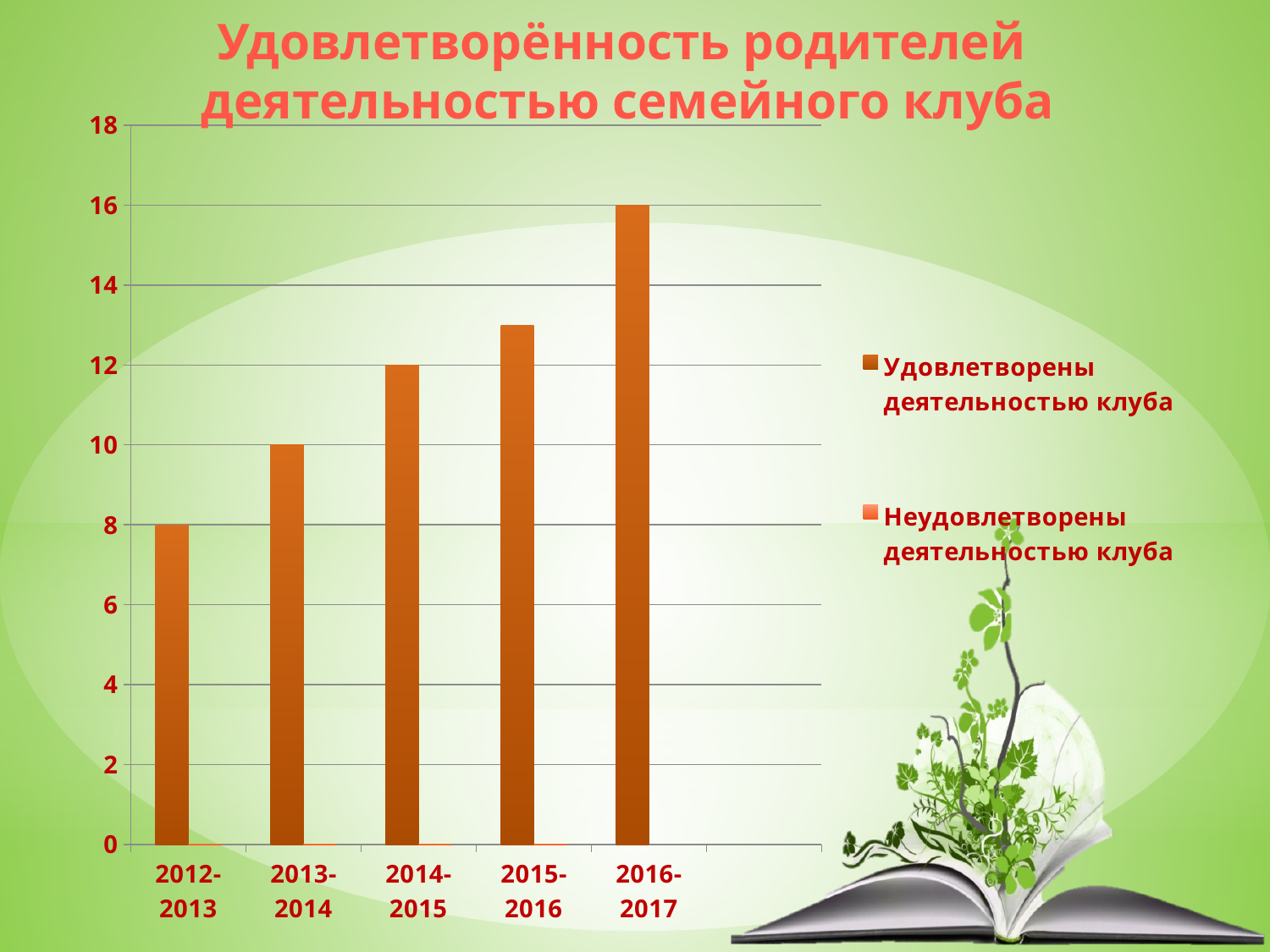
How many year categories are shown on the x axis? 5 What is the value for 'Удовлетворены деятельностью клуба' in 2012-2013? 8 What is the value for 'Удовлетворены деятельностью клуба' in 2014-2015? 12 Which year has the lowest value for 'Удовлетворены деятельностью клуба'? 2012-2013 What kind of chart is shown on the slide? bar chart Is the value for 'Удовлетворены деятельностью клуба' in 2015-2016 greater or less than 12? greater Which year has the highest value for 'Удовлетворены деятельностью клуба'? 2016-2017 What is the value for 'Удовлетворены деятельностью клуба' in 2013-2014? 10 What is the difference between the 'Удовлетворены деятельностью клуба' values for 2016-2017 and 2012-2013? 8 Do the values for 'Удовлетворены деятельностью клуба' rise or fall from 2012-2013 to 2016-2017? rise How many series does the legend list? 2 What is the value for 'Удовлетворены деятельностью клуба' in 2016-2017? 16